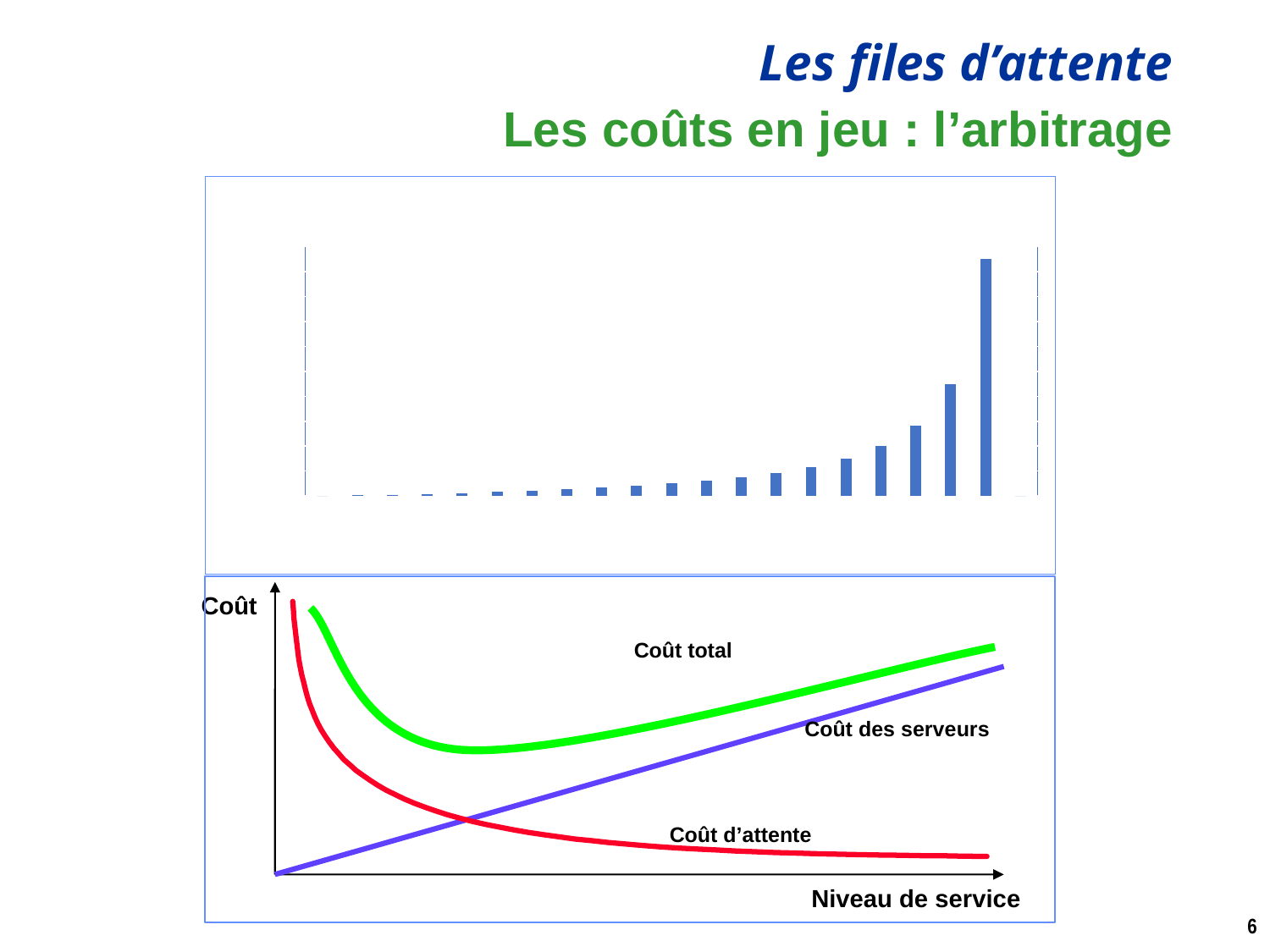
In the top bar chart, do the bar values rise or fall from left to right? rise In the bottom chart, does the curve labelled 'Coût d'attente' rise or fall as the niveau de service increases? fall In the bottom chart, what colour is the curve labelled 'Coût total'? green What kind of chart is the bottom chart on the slide? line chart How many curves are drawn in the bottom chart? 3 In the bottom chart, at the right end of the x axis, which is higher: 'Coût des serveurs' or 'Coût d'attente'? Coût des serveurs What is the label of the horizontal axis in the bottom chart? Niveau de service In the bottom chart, which curve first falls and then rises along the x axis? Coût total What kind of chart is the top chart on the slide? bar chart In the top bar chart, which bar is the highest, the leftmost or the rightmost? the rightmost In the top bar chart, is the rightmost bar taller than the second bar from the right? yes